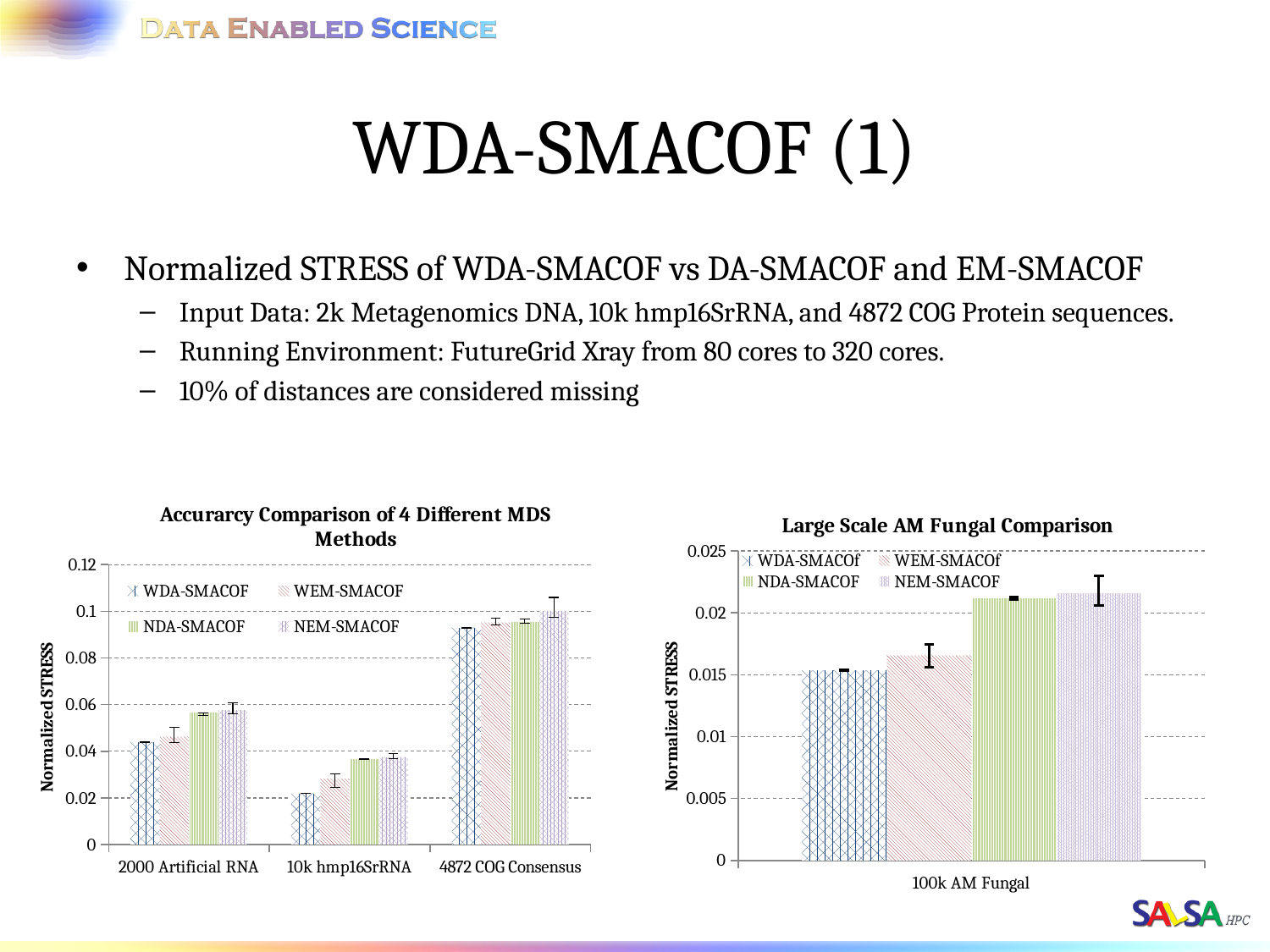
What is the title of the chart on the right of the slide? Large Scale AM Fungal Comparison In the 'Accurarcy Comparison of 4 Different MDS Methods' chart, which category has the lowest WDA-SMACOF value? 10k hmp16SrRNA In the 'Accurarcy Comparison of 4 Different MDS Methods' chart, how many series does the legend list? 4 In the 'Large Scale AM Fungal Comparison' chart, which series has the lowest value? WDA-SMACOf In the 'Accurarcy Comparison of 4 Different MDS Methods' chart, how many categories are shown on the x axis? 3 In the 'Accurarcy Comparison of 4 Different MDS Methods' chart, for 2000 Artificial RNA, which is larger: WDA-SMACOF or NDA-SMACOF? NDA-SMACOF What kind of chart is the 'Accurarcy Comparison of 4 Different MDS Methods' chart? bar chart In the 'Accurarcy Comparison of 4 Different MDS Methods' chart, which category has the highest WDA-SMACOF value? 4872 COG Consensus In the 'Large Scale AM Fungal Comparison' chart, how many series does the legend list? 4 In the 'Accurarcy Comparison of 4 Different MDS Methods' chart, is the WDA-SMACOF value for 10k hmp16SrRNA greater or less than 0.04? less In the 'Accurarcy Comparison of 4 Different MDS Methods' chart, is the NEM-SMACOF value for 4872 COG Consensus greater or less than 0.08? greater In the 'Large Scale AM Fungal Comparison' chart, is the WDA-SMACOf value greater or less than 0.02? less